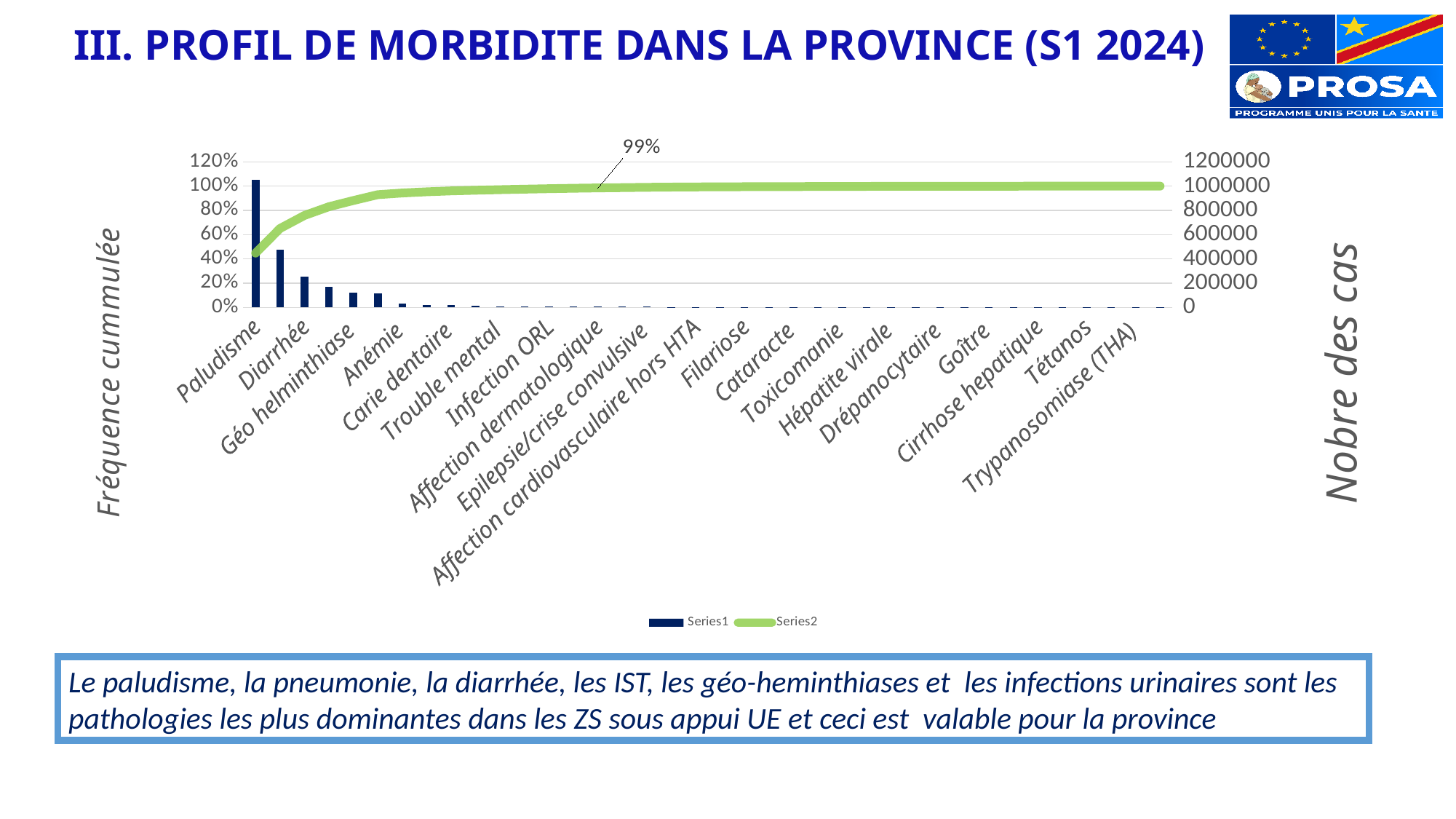
Is the bar for Anémie greater or less than 200000 on the right axis? less Which has a taller bar, Diarrhée or Géo helminthiase? Diarrhée Which category has the tallest bar in the chart? Paludisme Do the bar values rise or fall from left to right along the x axis? fall Is the bar for Géo helminthiase greater or less than 400000 on the right axis? less Which has a taller bar, Paludisme or Diarrhée? Paludisme Is the bar for Diarrhée greater or less than 600000 on the right axis? less How many series does the legend list? 2 What is the title of the left vertical axis? Fréquence cummulée What value is printed as a data label on the green line in the chart? 99% Does the green line rise or fall from left to right along the x axis? rise